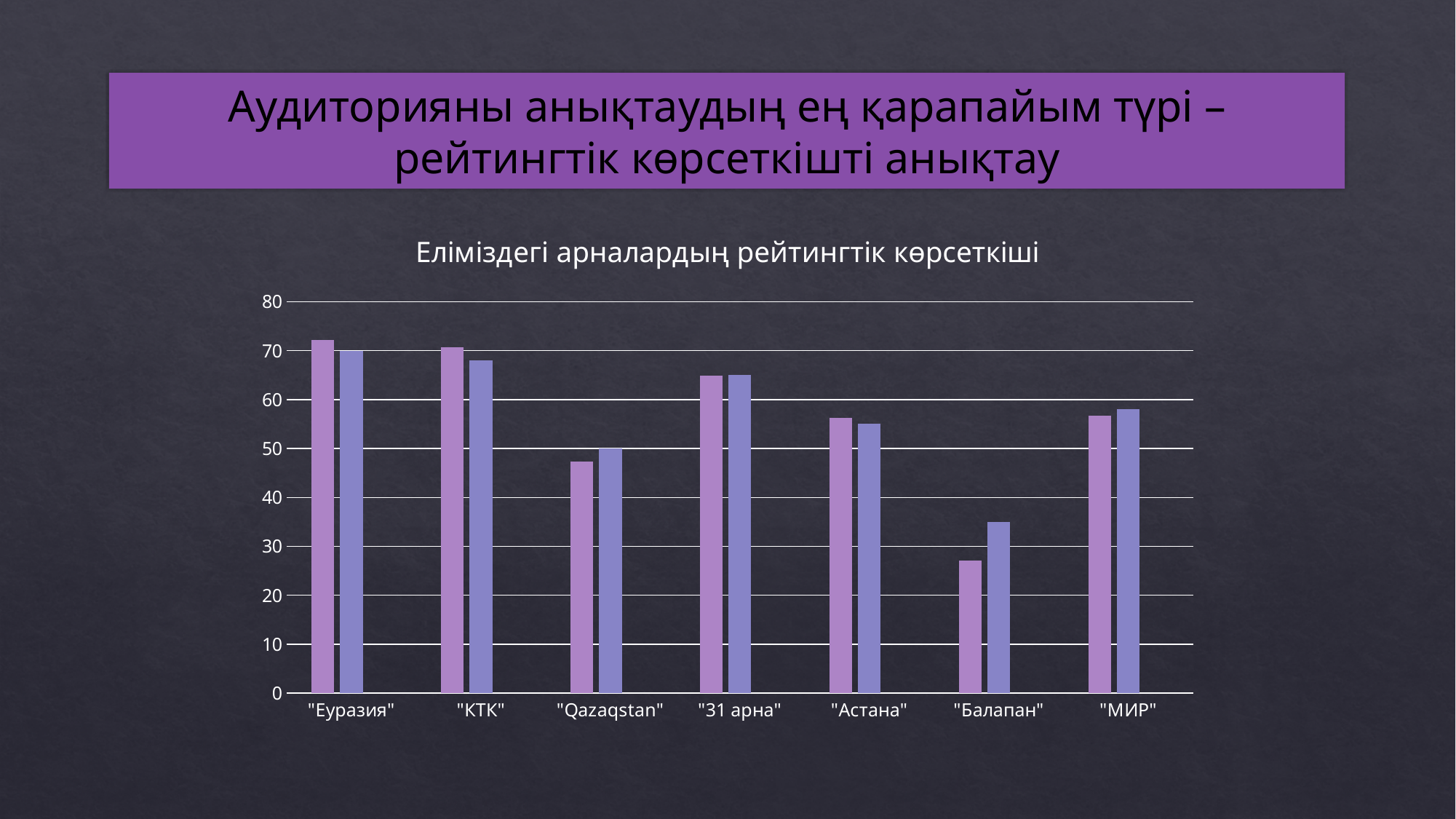
Is the value of the pink (left) bar for "Астана" greater or less than 50? greater What kind of chart is shown on the slide? Bar chart Which channel has a higher pink (left) bar, "Qazaqstan" or "31 арна"? "31 арна" Which channel has the lowest bars in the chart? "Балапан" What is the title of the chart? Еліміздегі арналардың рейтингтік көрсеткіші How many bars are plotted for each channel in the chart? 2 For "Балапан", which bar is larger, the pink (left) one or the blue (right) one? The blue (right) one How many channels (categories) are shown on the x axis of the chart? 7 Is the value of the blue (right) bar for "КТК" greater or less than 70? less Is the value of the blue (right) bar for "Балапан" greater or less than 30? greater